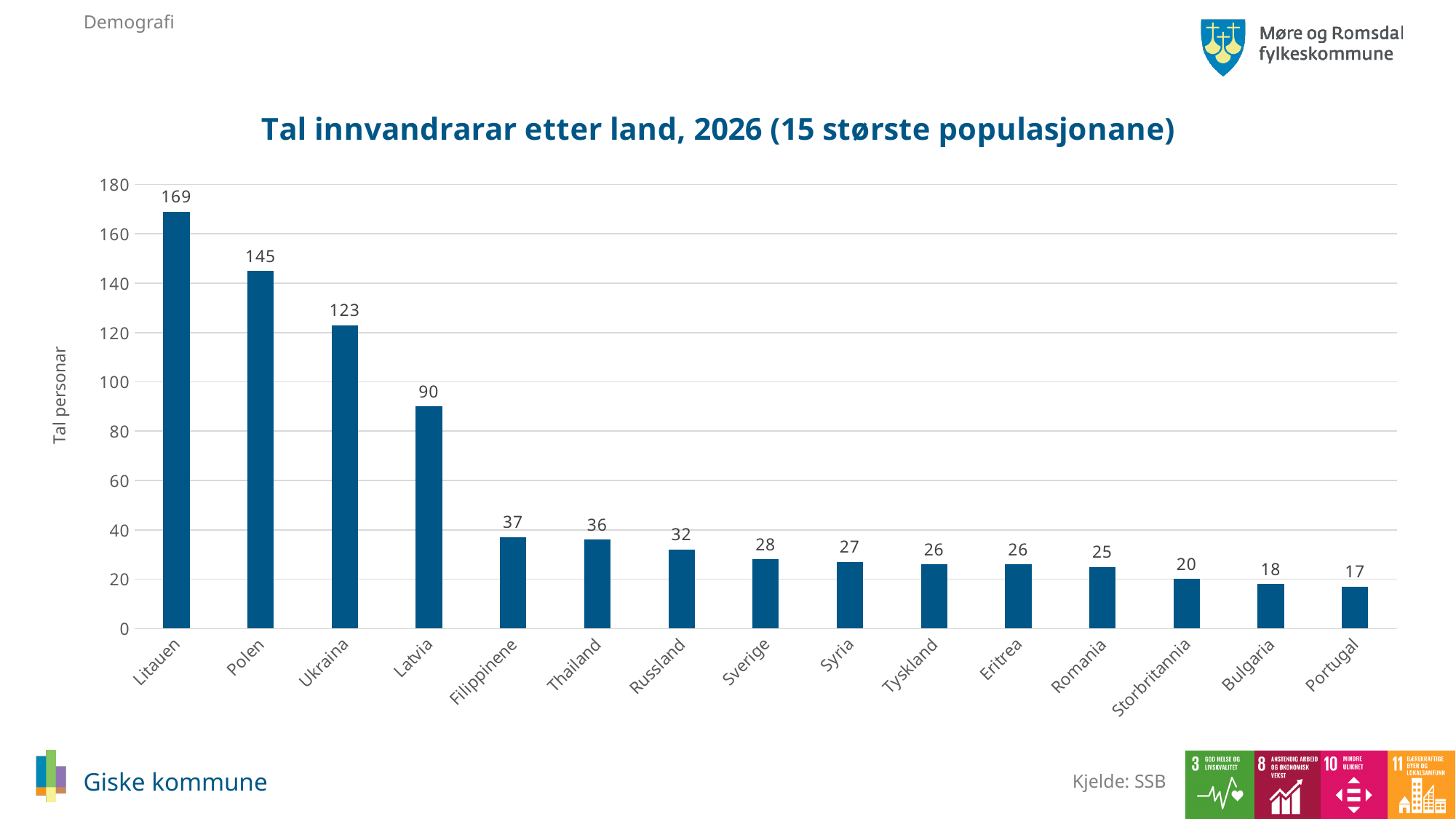
What is the value for Litauen? 169 Do the values rise or fall from left to right along the x axis? fall What is the value for Storbritannia? 20 What is the difference between the values for Polen and Latvia? 55 What is the title of the chart? Tal innvandrarar etter land, 2026 (15 største populasjonane) Is the value for Latvia greater or less than 100? less How many countries are shown in the chart? 15 Which country has the lowest value? Portugal Which country has the highest value? Litauen What is the value for Ukraina? 123 What kind of chart is shown on the slide? bar chart Which is larger, the value for Filippinene or the value for Russland? Filippinene